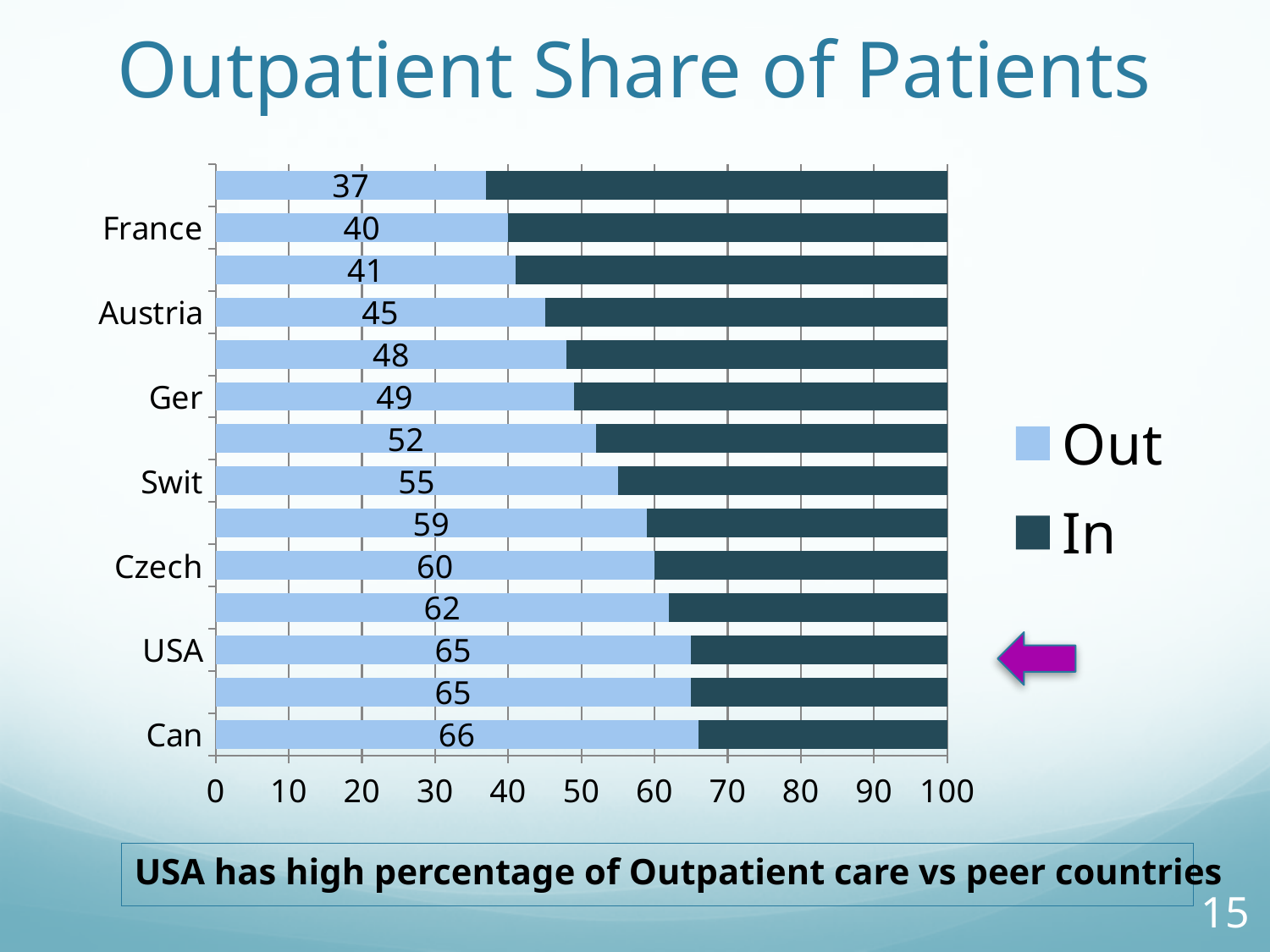
What kind of chart is shown on the slide? Stacked bar chart Which has a larger Out value, Swit or Austria? Swit What is the difference between the Out values for USA and France? 25 How many series does the legend list? 2 How many bars are plotted in the chart? 14 What is the Out value for USA? 65 What is the Out value for Can? 66 What is the Out value for Ger? 49 Which country has the highest Out value? Can What is the Out value for France? 40 Among the labeled countries, which has the lowest Out value? France What are the two legend entries in the chart? Out and In